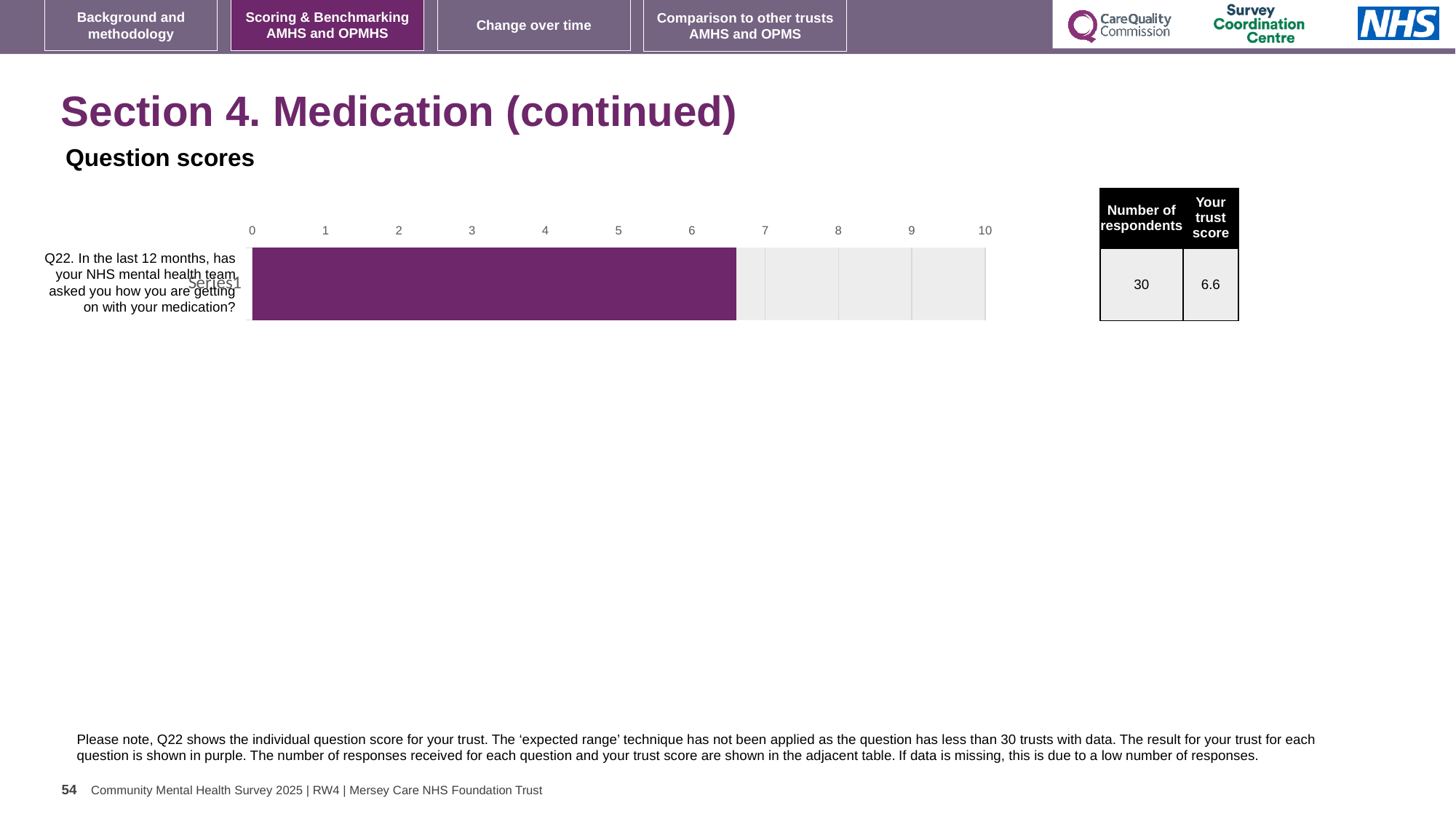
How many respondents are listed in the table for Q22? 30 What colour is the bar for Q22? purple How many bars are plotted in the chart? 1 Is the value of the bar for Q22 greater or less than 7? less Is the value of the bar for Q22 greater or less than 5? greater Is the value of the bar for Q22 greater or less than 6? greater What kind of chart is shown on the slide? bar chart What is the highest value shown on the chart's axis? 10 What is the trust score for Q22 shown in the adjacent table? 6.6